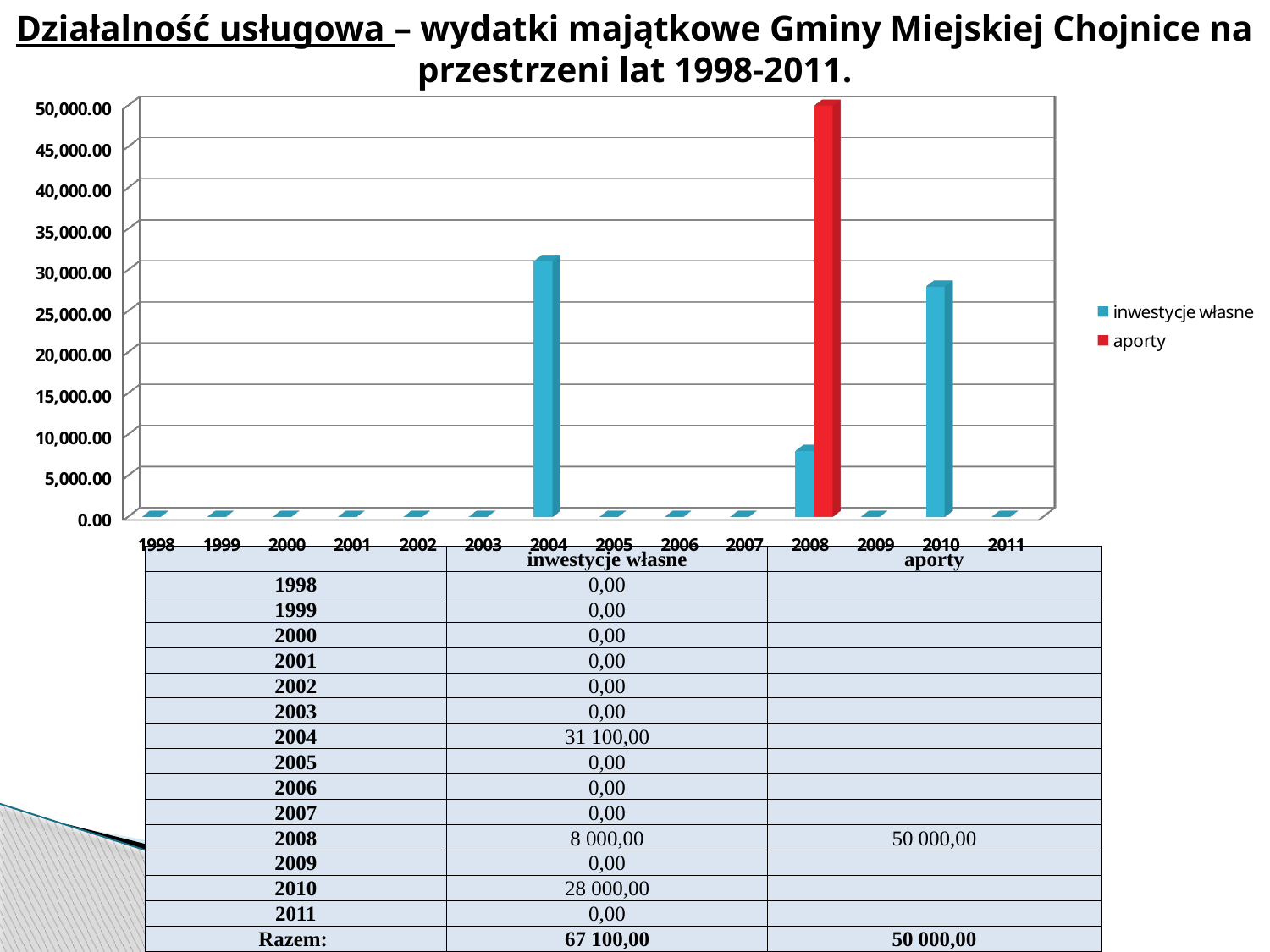
How many years are shown on the x axis of the chart? 14 How many series does the chart legend list? 2 What is the value of inwestycje własne for 2008? 8 000,00 Which series is shown in red in the chart? aporty What is the value of aporty for 2008? 50 000,00 Is the value for inwestycje własne in 2008 greater or less than 10,000.00? less Which year has the highest value for inwestycje własne? 2004 Which is larger, inwestycje własne in 2004 or inwestycje własne in 2010? 2004 What kind of chart is shown on the slide? bar chart What is the value of inwestycje własne for 2010? 28 000,00 What is the difference between inwestycje własne in 2004 and in 2010? 3 100,00 What is the value of inwestycje własne for 2004? 31 100,00